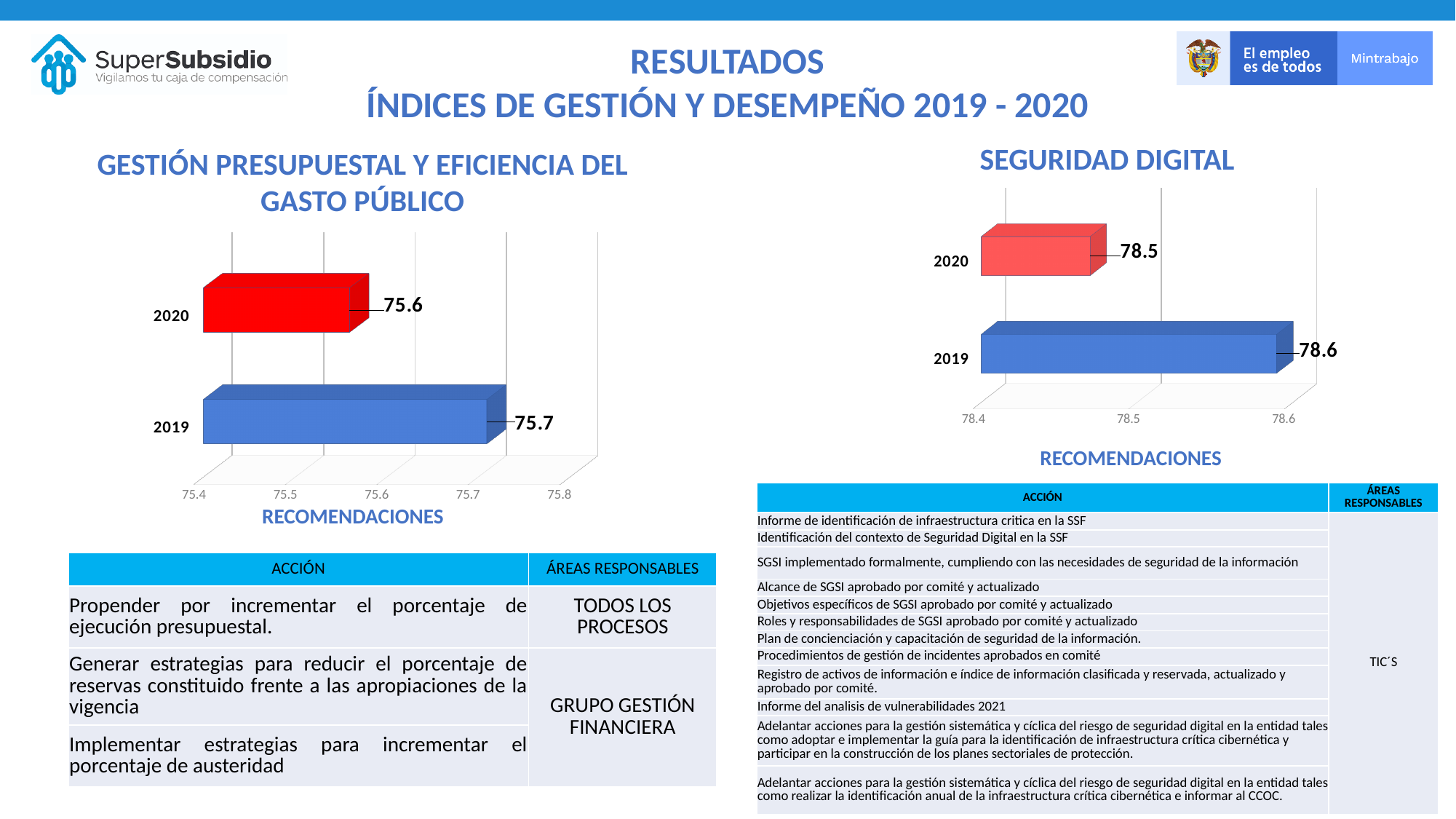
In the GESTIÓN PRESUPUESTAL Y EFICIENCIA DEL GASTO PÚBLICO chart, what is the difference between the 2019 and 2020 values? 0.1 In the SEGURIDAD DIGITAL chart, which year has the lower value? 2020 In the SEGURIDAD DIGITAL chart, is the value for 2019 larger or smaller than the value for 2020? larger How many bars are plotted in the GESTIÓN PRESUPUESTAL Y EFICIENCIA DEL GASTO PÚBLICO chart? 2 In the GESTIÓN PRESUPUESTAL Y EFICIENCIA DEL GASTO PÚBLICO chart, what is the value for 2020? 75.6 In the SEGURIDAD DIGITAL chart, what colour is the bar for 2020? Red In the SEGURIDAD DIGITAL chart, what is the value for 2020? 78.5 What kind of chart is the SEGURIDAD DIGITAL chart? Bar chart In the GESTIÓN PRESUPUESTAL Y EFICIENCIA DEL GASTO PÚBLICO chart, which year has the higher value? 2019 In the GESTIÓN PRESUPUESTAL Y EFICIENCIA DEL GASTO PÚBLICO chart, what is the value for 2019? 75.7 In the SEGURIDAD DIGITAL chart, what is the value for 2019? 78.6 In the SEGURIDAD DIGITAL chart, what is the difference between the 2019 and 2020 values? 0.1